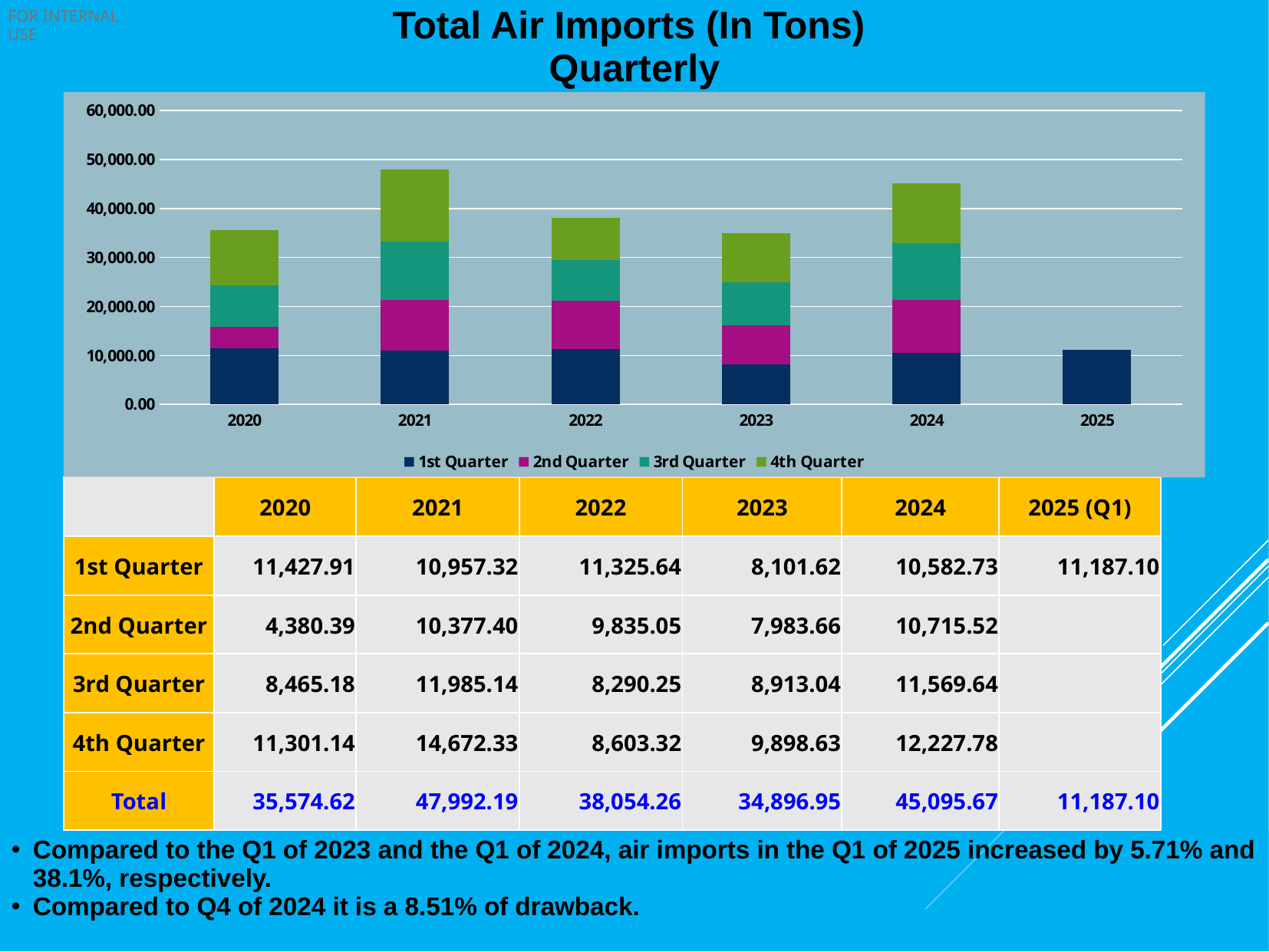
What is the total air imports value for 2024? 45,095.67 Which year has the lowest total stacked bar? 2025 What kind of chart is shown on the slide? Stacked bar chart Which year has the highest total stacked bar? 2021 How many series does the legend list? 4 Which year has the larger 2nd Quarter value, 2021 or 2022? 2021 What is the difference between the 2024 total and the 2023 total? 10,198.72 What colour represents the 4th Quarter series in the chart? Green What is the 4th Quarter value for 2021? 14,672.33 What is the 1st Quarter value for 2020? 11,427.91 Is the total for 2021 greater or less than 40,000.00? greater How many years are shown on the x axis of the chart? 6